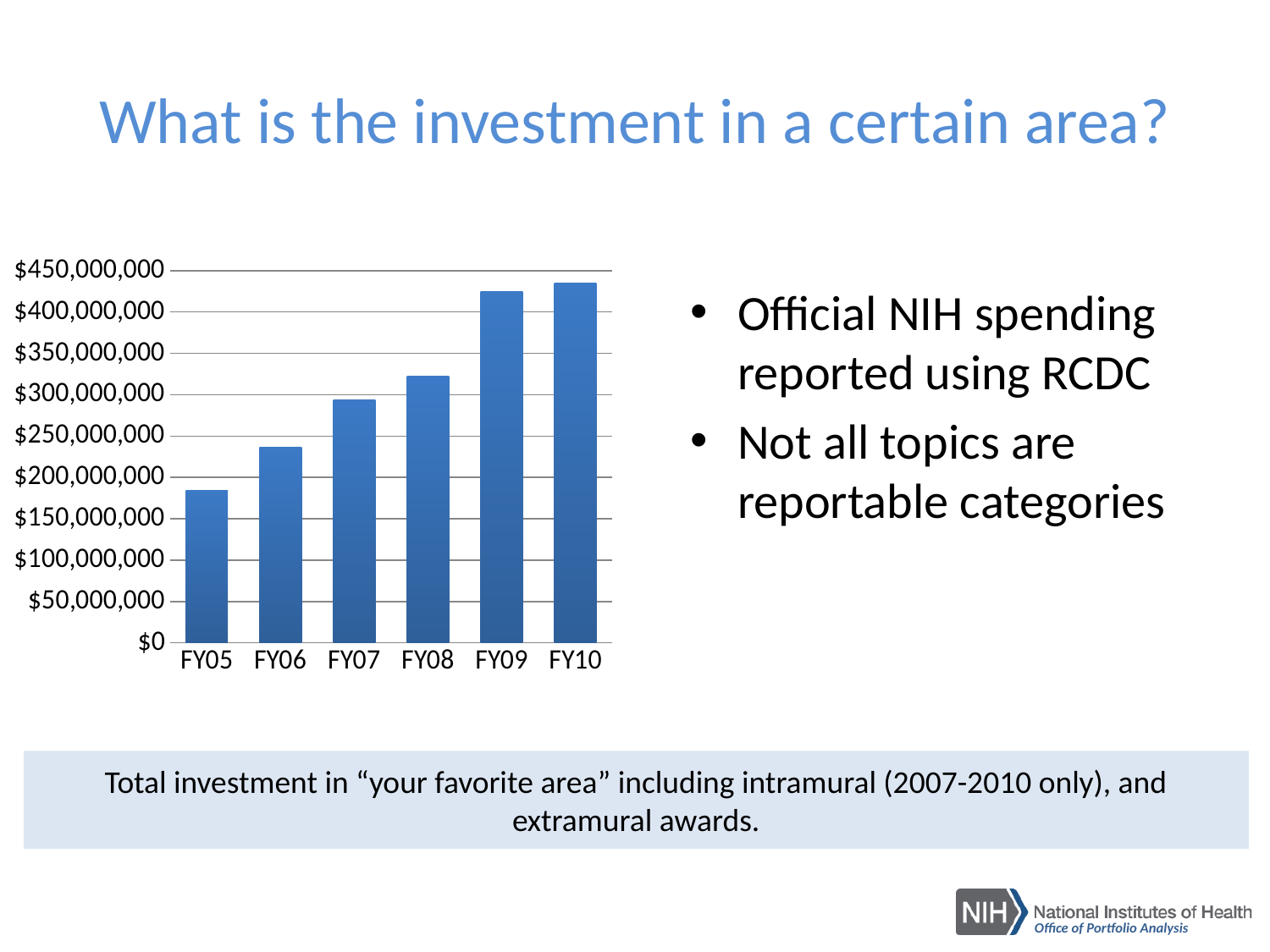
What is the highest value labelled on the vertical axis of the chart? $450,000,000 What is the label of the first category on the horizontal axis of the chart? FY05 Is the value for FY08 greater or less than $350,000,000? less Which is larger, the value for FY05 or the value for FY08? FY08 Do the values in the chart rise or fall from FY05 to FY10? rise Is the value for FY05 greater or less than $200,000,000? less Is the value for FY06 greater or less than $200,000,000? greater How many fiscal years are plotted in the chart? 6 Which fiscal year has the lowest investment in the chart? FY05 What kind of chart is shown on the slide? bar chart